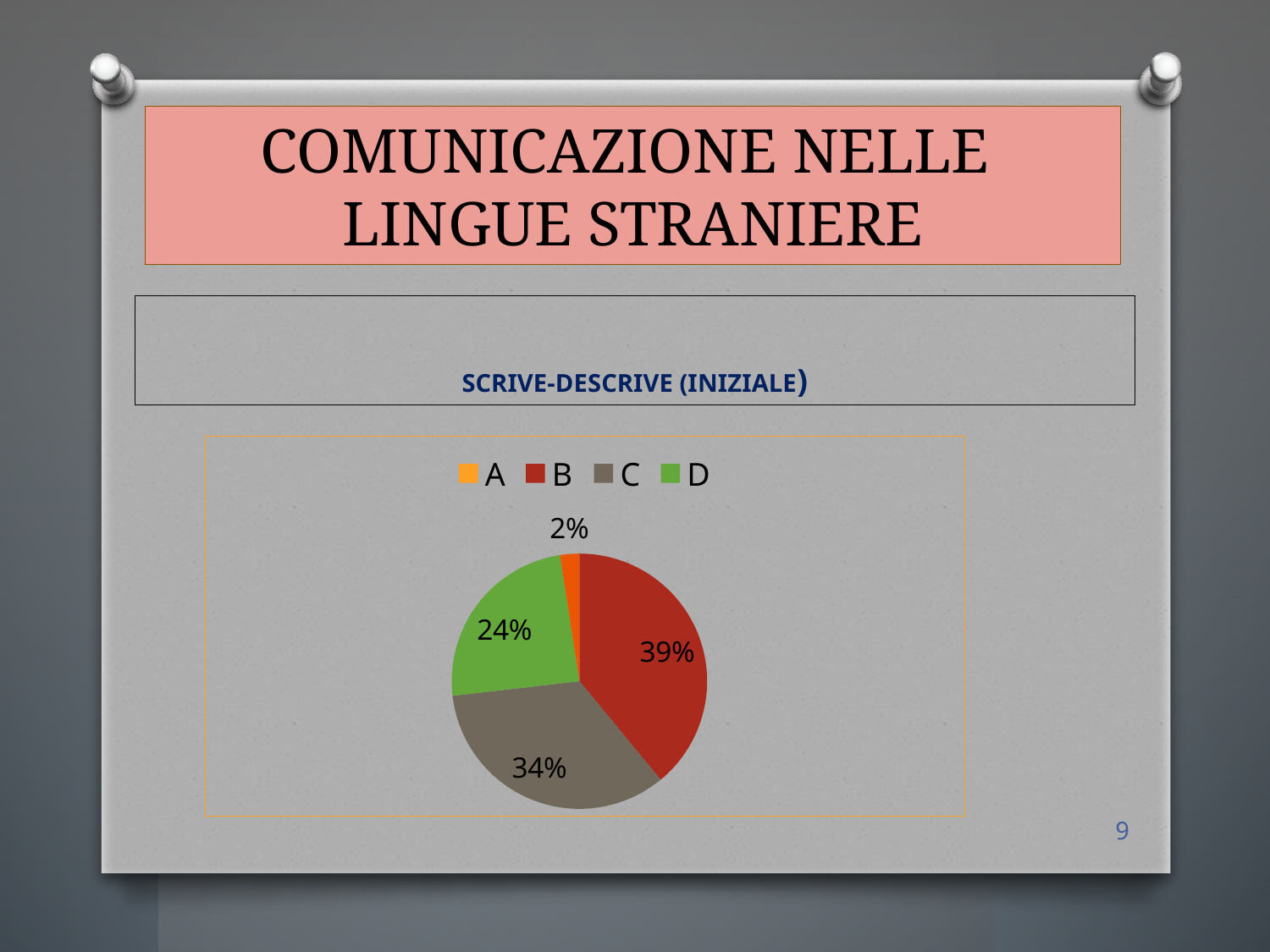
How many categories does the legend list? 4 Which category has the largest slice of the pie? B Which category has the smallest slice of the pie? A What kind of chart is shown on the slide? pie chart What is the title of the chart? SCRIVE-DESCRIVE (INIZIALE) What is the share for category D? 24% What is the share for category A? 2% Which is larger, the share for C or the share for D? C What is the difference between the shares of B and C? 5% What is the share for category C? 34% What is the share for category B? 39% What colour is the slice for category D? green